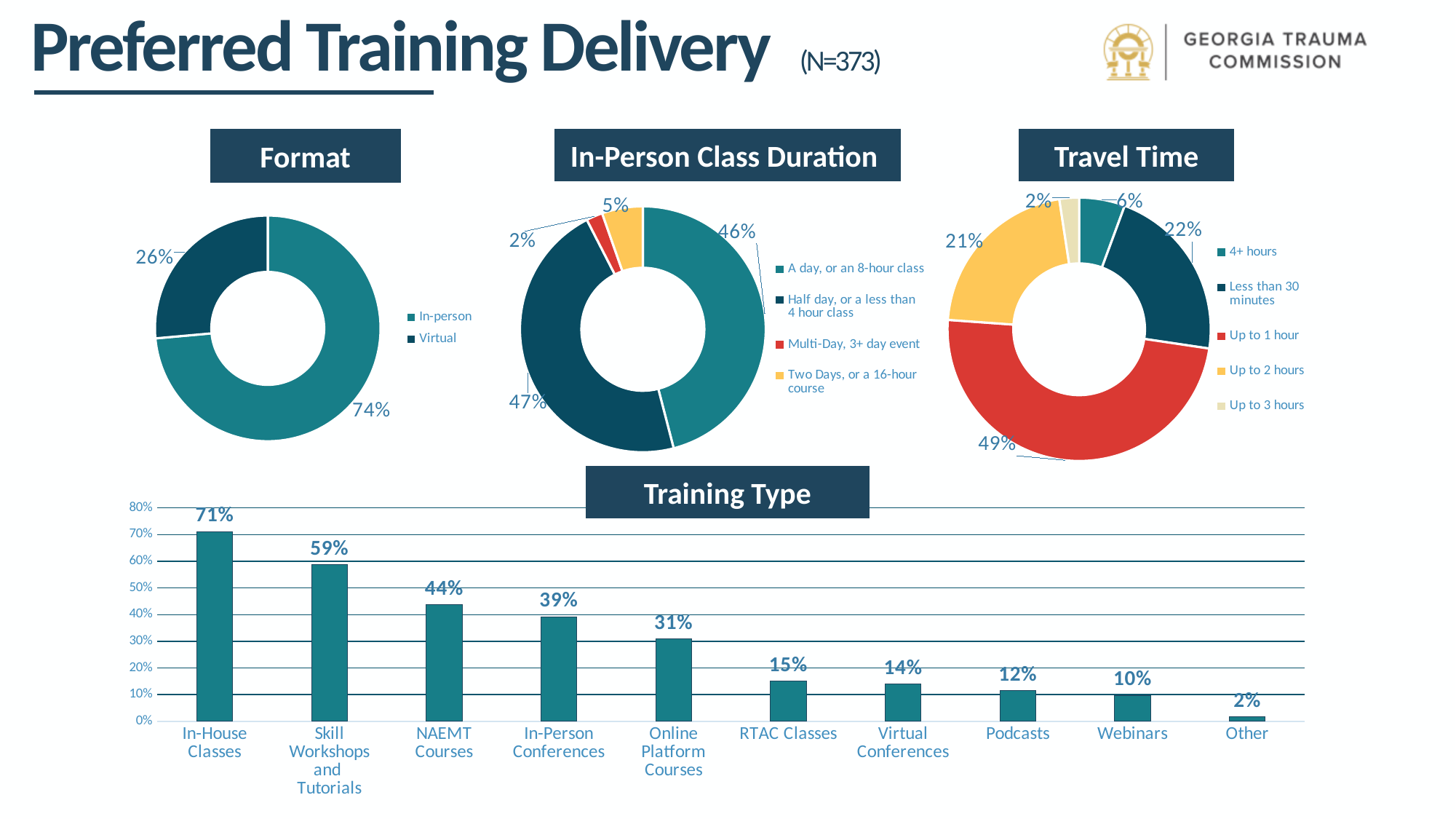
In the In-Person Class Duration chart, which category has the lowest value? Multi-Day, 3+ day event In the Travel Time chart, what is the value for Less than 30 minutes? 22% In the Training Type chart, what is the value for NAEMT Courses? 44% In the Training Type chart, what is the difference between In-House Classes and Skill Workshops and Tutorials? 12% In the Travel Time chart, how many categories does the legend list? 5 In the In-Person Class Duration chart, what is the value for Two Days, or a 16-hour course? 5% In the Format chart, what share of respondents preferred In-person? 74% In the Format chart, what is the value for Virtual? 26% What kind of chart is the Training Type chart? Bar chart In the Travel Time chart, which category has the highest value? Up to 1 hour In the Training Type chart, which category has the highest value? In-House Classes In the Training Type chart, which is larger, Podcasts or Webinars? Podcasts